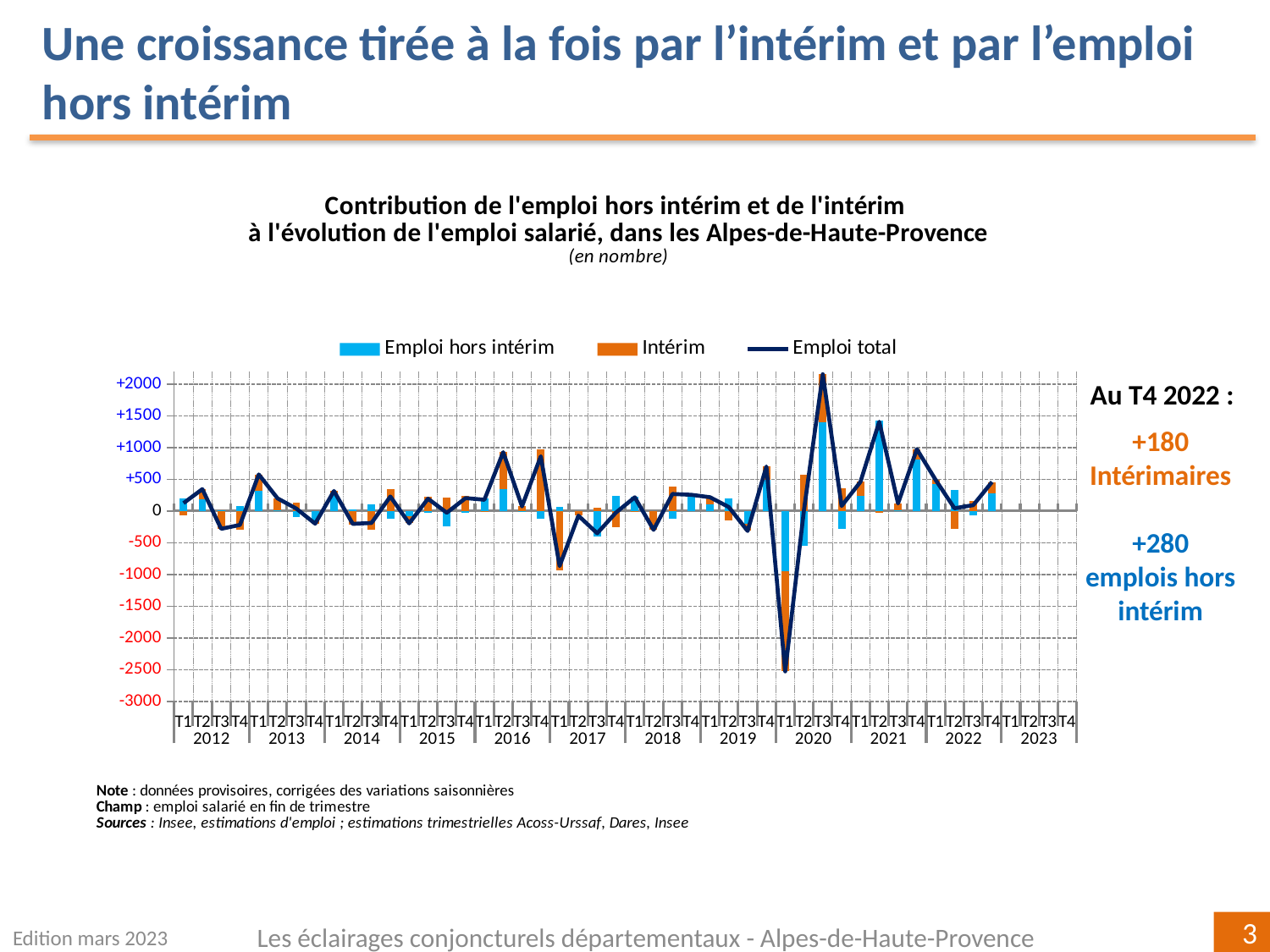
According to the slide, what is the value for Emploi hors intérim at T4 2022? +280 According to the slide, what is the value for Intérim at T4 2022? +180 What kind of chart is shown on the slide? A combined bar and line chart In which quarter does the Emploi total line reach its lowest point? T1 2020 Is the Emploi total value at T3 2020 greater or less than +2000? greater How many years are labelled along the x axis of the chart? 12 Which colour represents the Intérim series in the chart? Orange How many series does the chart legend list? 3 Is the Emploi total value at T1 2020 greater or less than -2000? less Is the Emploi total value at T2 2021 greater or less than +1000? greater Which is larger, the Emploi total value at T3 2020 or at T2 2021? T3 2020 In which quarter does the Emploi total line reach its highest point? T3 2020